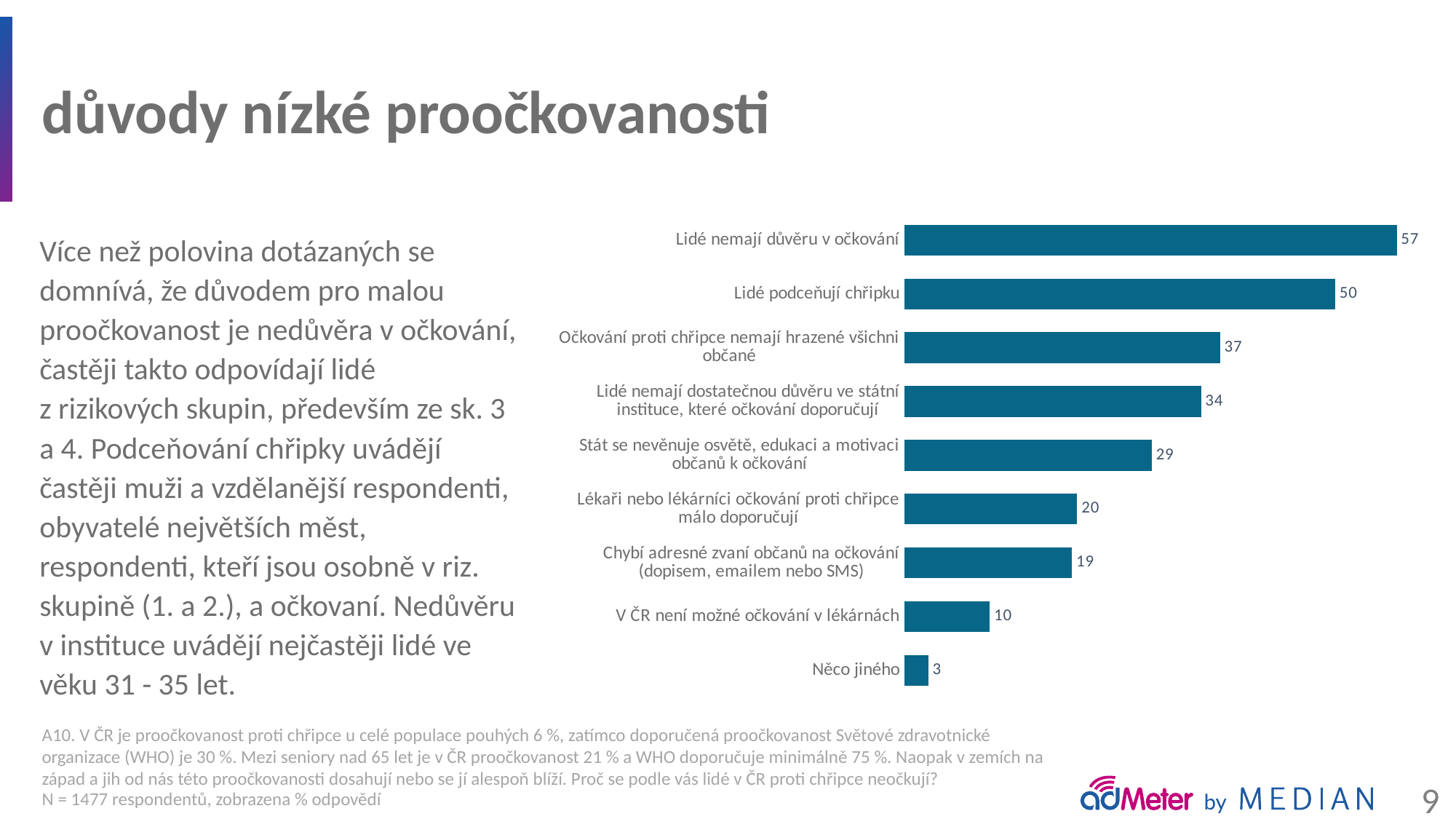
What is the difference between the values for "Lidé nemají důvěru v očkování" and "Lidé podceňují chřipku"? 7 Which category has the highest value? Lidé nemají důvěru v očkování What kind of chart is shown on the slide? Bar chart What is the value for "Lidé podceňují chřipku"? 50 What is the value for "V ČR není možné očkování v lékárnách"? 10 How many categories does the chart show? 9 What is the title of the slide? důvody nízké proočkovanosti What is the value for "Lidé nemají důvěru v očkování"? 57 Which is larger: the value for "Lékaři nebo lékárníci očkování proti chřipce málo doporučují" or for "Chybí adresné zvaní občanů na očkování (dopisem, emailem nebo SMS)"? Lékaři nebo lékárníci očkování proti chřipce málo doporučují What is the difference between the values for "Očkování proti chřipce nemají hrazené všichni občané" and "Něco jiného"? 34 What is the value for "Stát se nevěnuje osvětě, edukaci a motivaci občanů k očkování"? 29 Which category has the lowest value? Něco jiného